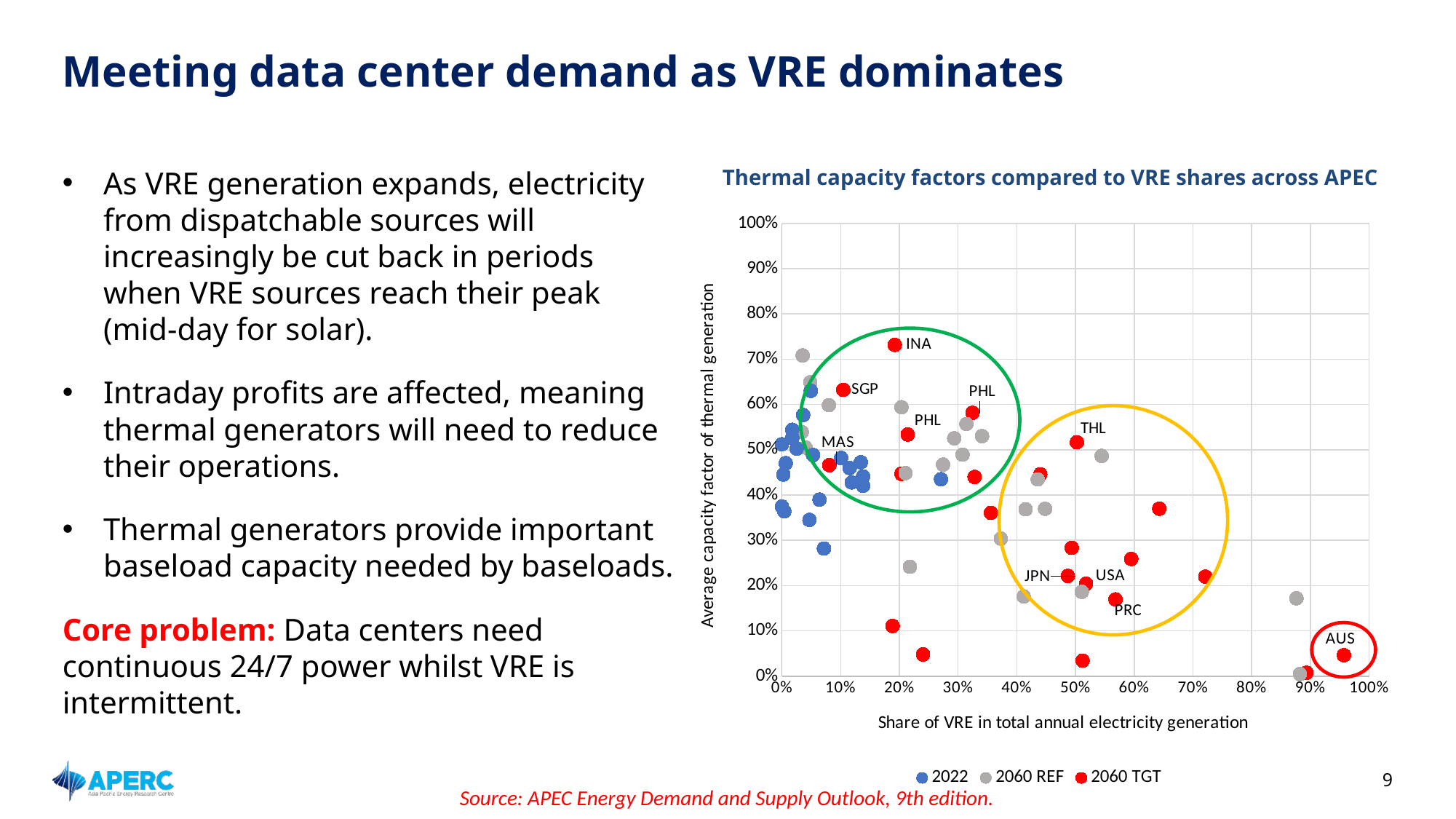
Among the labelled economies, which has the highest average capacity factor of thermal generation? INA What kind of chart is shown on the slide? Scatter chart How many series does the chart legend list? 3 Is the average capacity factor of thermal generation for AUS greater or less than 10%? less What are the three series named in the chart legend? 2022, 2060 REF, 2060 TGT Is the average capacity factor of thermal generation for INA greater or less than 60%? greater What is the title of the chart? Thermal capacity factors compared to VRE shares across APEC Is the average capacity factor of thermal generation for PRC greater or less than 20%? less Which has a higher average capacity factor of thermal generation, INA or SGP? INA Which has a higher share of VRE in total annual electricity generation, AUS or THL? AUS